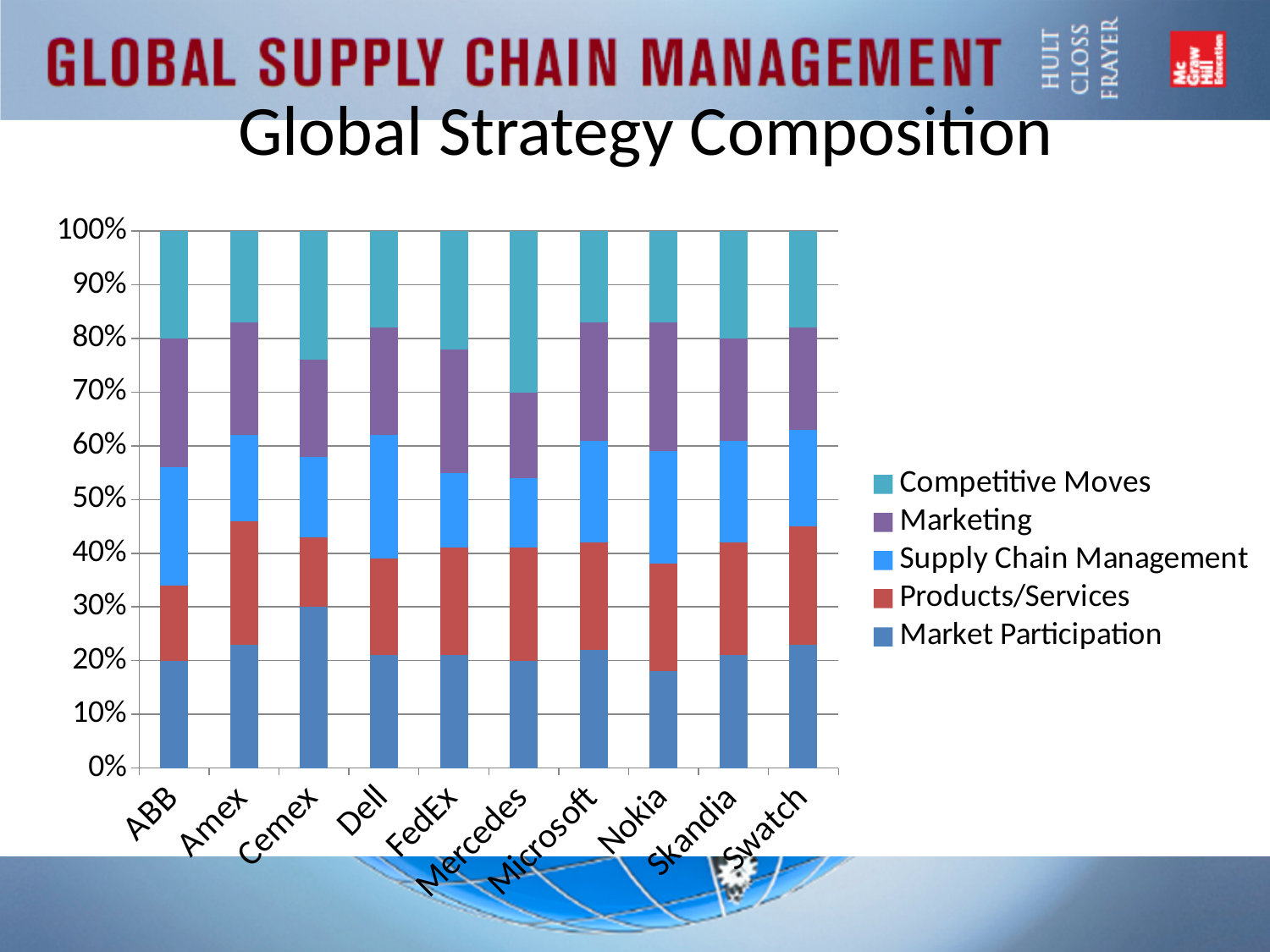
How many companies are shown along the x axis of the chart? 10 Is the Market Participation value for Cemex greater or less than 20%? greater Which company has the largest Competitive Moves segment? Mercedes What is the total height of the stacked bar for ABB? 100% Is the Market Participation value for Nokia greater or less than 30%? less Is the Competitive Moves segment for Mercedes greater or less than 20%? greater What kind of chart is shown on the slide? Stacked bar chart Which company has the larger Market Participation segment, Cemex or Nokia? Cemex How many series does the chart's legend list? 5 Which series is shown at the bottom of each stacked bar? Market Participation What is the title of the chart? Global Strategy Composition Which company has the largest Market Participation segment? Cemex